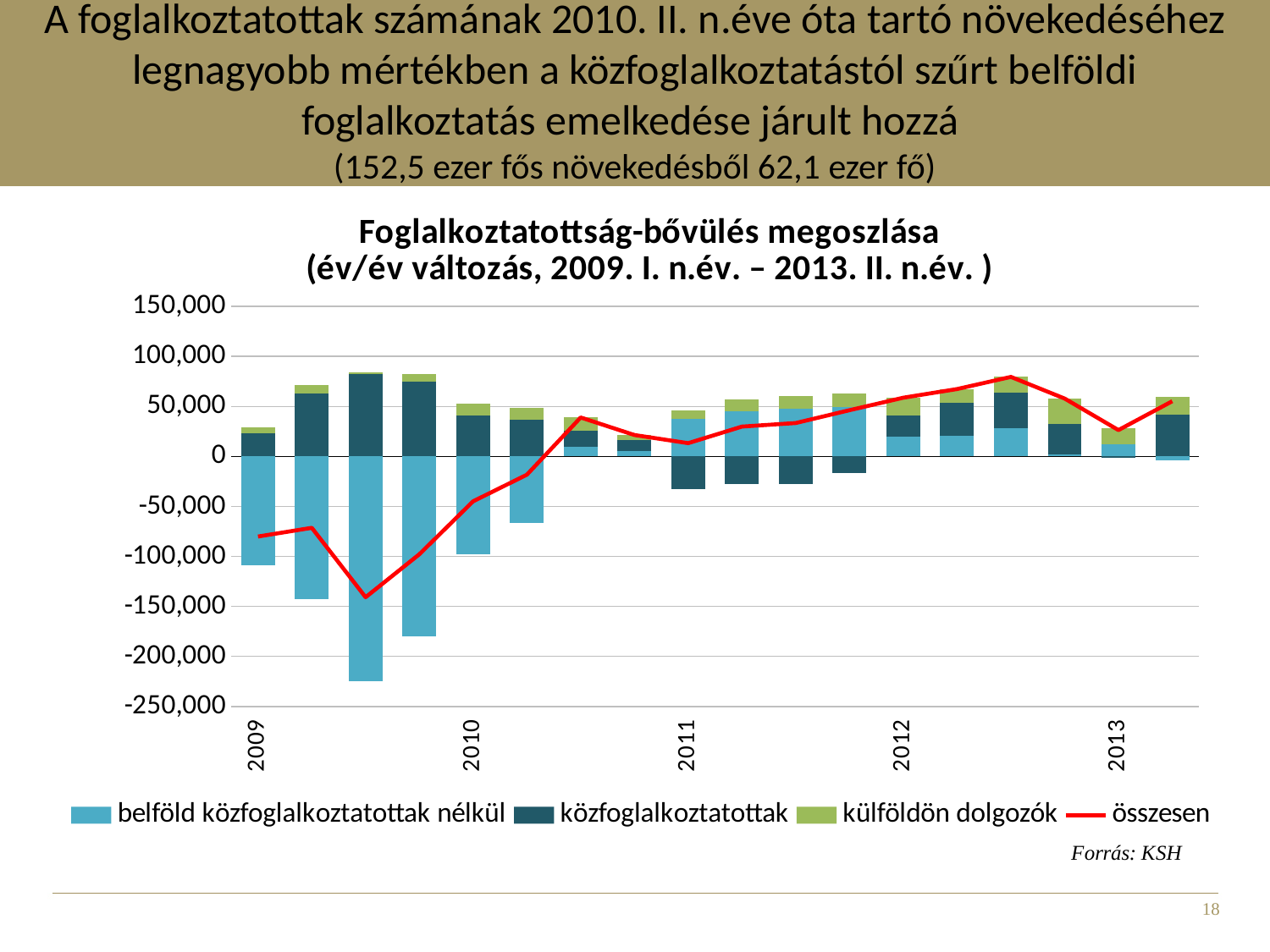
Is the 'belföld közfoglalkoztatottak nélkül' value for the third bar of 2009 greater or less than -200,000? less In which year does the 'összesen' line reach its highest point? 2012 Which series is drawn as a red line? összesen Is the 'összesen' line value at the third quarter of 2012 greater or less than 50,000? greater What is the title of the chart? Foglalkoztatottság-bővülés megoszlása (év/év változás, 2009. I. n.év. – 2013. II. n.év. ) In which year does the 'összesen' line reach its lowest point? 2009 How many series does the legend list? 4 Does the 'összesen' line rise or fall between the third quarter of 2009 and the third quarter of 2010? rise What kind of chart is shown on the slide? Stacked bar chart with a line Which is larger: the 'összesen' value in the first quarter of 2009 or in the first quarter of 2012? first quarter of 2012 Is the 'összesen' line value at the third quarter of 2009 greater or less than -100,000? less How many bars (quarters) are plotted in the chart? 18